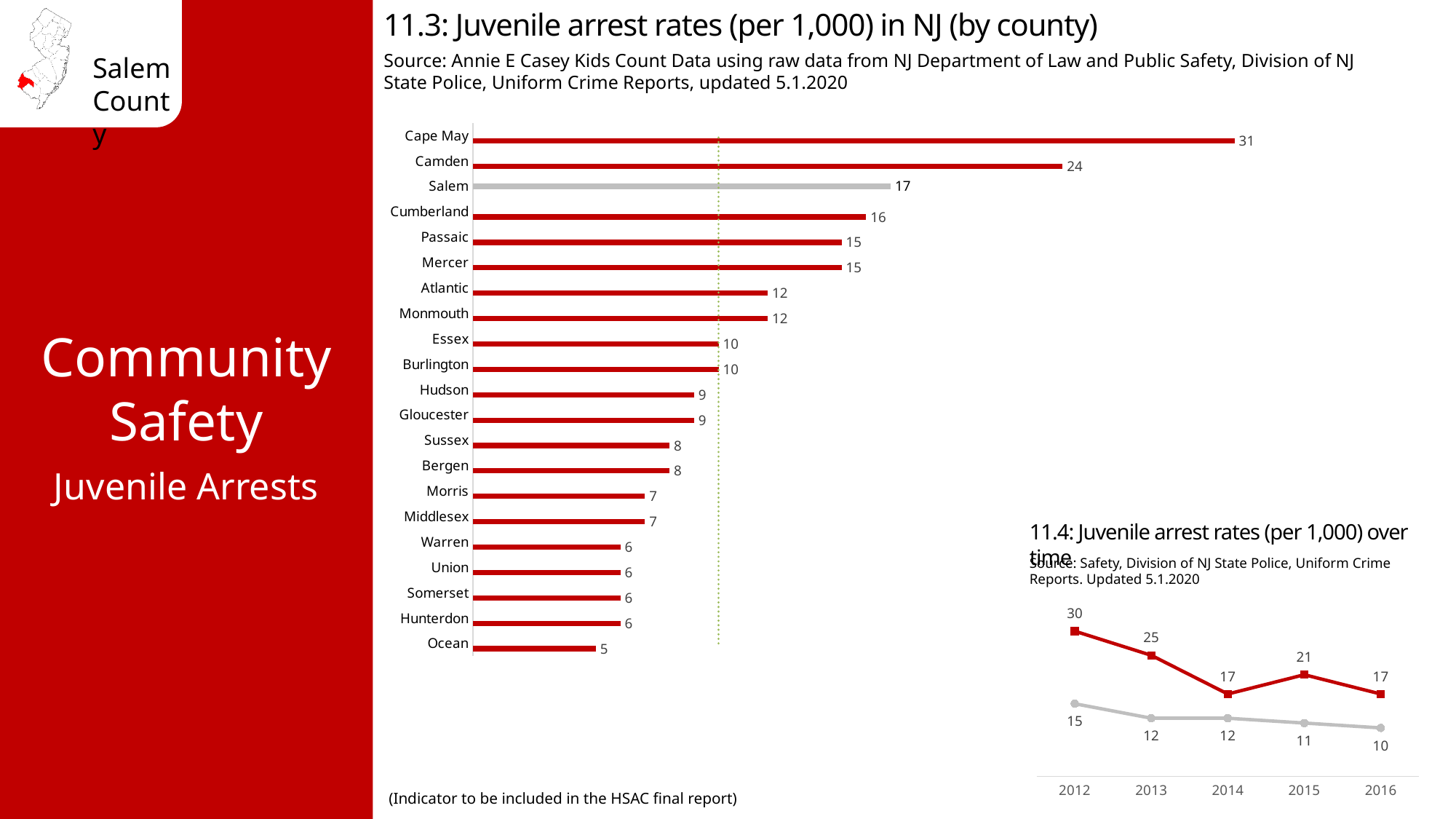
In the chart '11.3: Juvenile arrest rates (per 1,000) in NJ (by county)', which is larger, the value for Cumberland or the value for Atlantic? Cumberland In the chart '11.4: Juvenile arrest rates (per 1,000) over time', what is the value of the gray line in 2016? 10 In the chart '11.3: Juvenile arrest rates (per 1,000) in NJ (by county)', what is the value for Hudson? 9 In the chart '11.4: Juvenile arrest rates (per 1,000) over time', what is the value of the red line in 2012? 30 What kind of chart is '11.4: Juvenile arrest rates (per 1,000) over time'? Line chart In the chart '11.4: Juvenile arrest rates (per 1,000) over time', does the gray line generally rise or fall from 2012 to 2016? Fall In the chart '11.3: Juvenile arrest rates (per 1,000) in NJ (by county)', what is the value for Salem? 17 In the chart '11.3: Juvenile arrest rates (per 1,000) in NJ (by county)', which county has the highest value? Cape May In the chart '11.3: Juvenile arrest rates (per 1,000) in NJ (by county)', which county has the lowest value? Ocean In the chart '11.3: Juvenile arrest rates (per 1,000) in NJ (by county)', how many counties are shown? 21 What kind of chart is '11.3: Juvenile arrest rates (per 1,000) in NJ (by county)'? Bar chart In the chart '11.3: Juvenile arrest rates (per 1,000) in NJ (by county)', what is the difference between the values for Cape May and Camden? 7